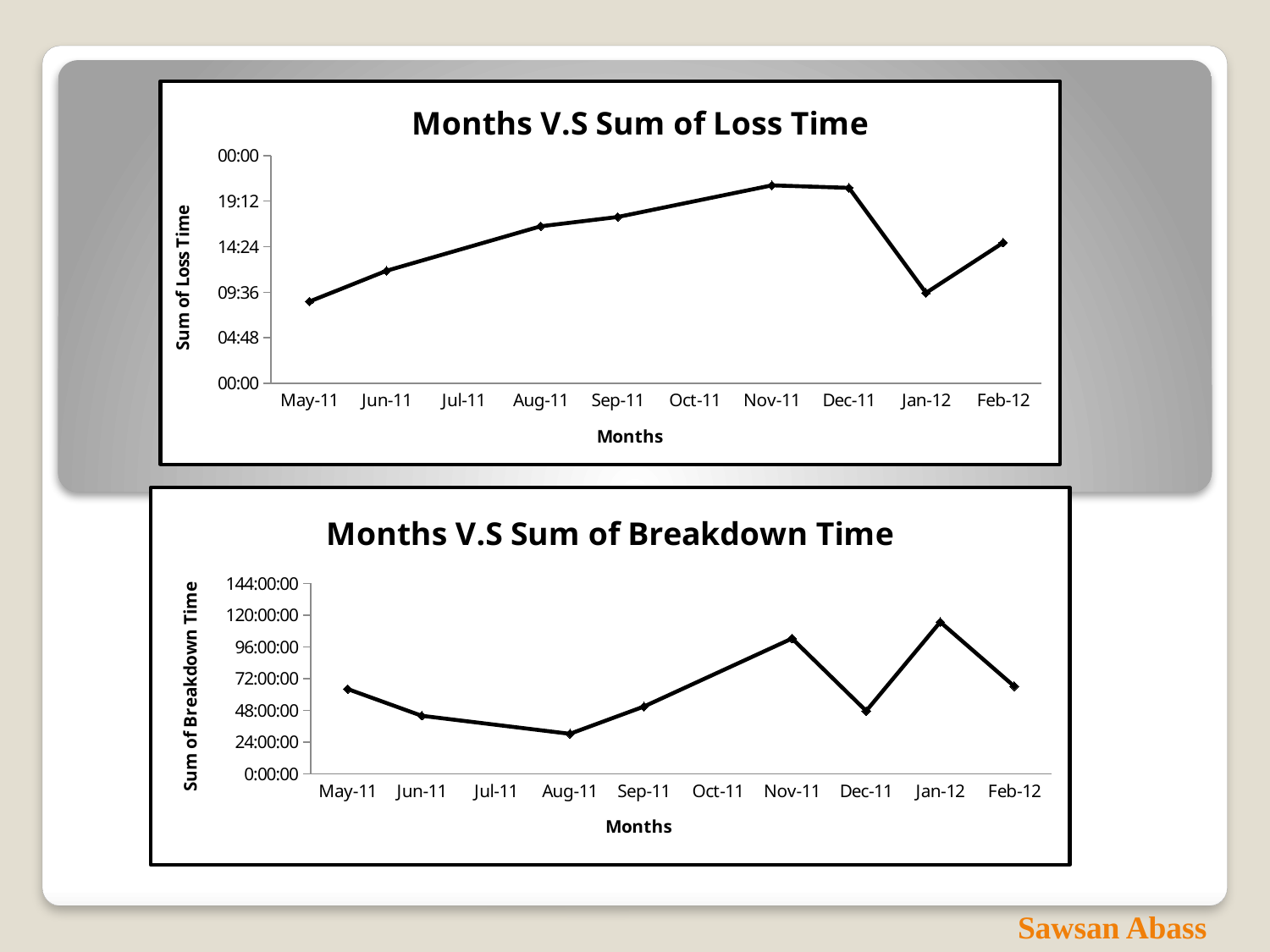
How many month labels are shown on the x axis of the 'Months V.S Sum of Loss Time' chart? 10 In the 'Months V.S Sum of Loss Time' chart, do the values rise or fall from May-11 to Nov-11? rise In the 'Months V.S Sum of Loss Time' chart, which month has the highest sum of loss time? Nov-11 What is the y-axis title of the bottom chart? Sum of Breakdown Time In the 'Months V.S Sum of Breakdown Time' chart, which is larger, the value for Nov-11 or the value for Sep-11? Nov-11 What kind of chart is the 'Months V.S Sum of Loss Time' chart? line chart In the 'Months V.S Sum of Loss Time' chart, is the value for Nov-11 greater or less than 19:12? greater In the 'Months V.S Sum of Breakdown Time' chart, which month has the lowest sum of breakdown time? Aug-11 In the 'Months V.S Sum of Loss Time' chart, is the value for May-11 greater or less than 09:36? less In the 'Months V.S Sum of Loss Time' chart, which is larger, the value for Aug-11 or the value for Jun-11? Aug-11 In the 'Months V.S Sum of Breakdown Time' chart, which month has the highest sum of breakdown time? Jan-12 In the 'Months V.S Sum of Breakdown Time' chart, is the value for Aug-11 greater or less than 48:00:00? less